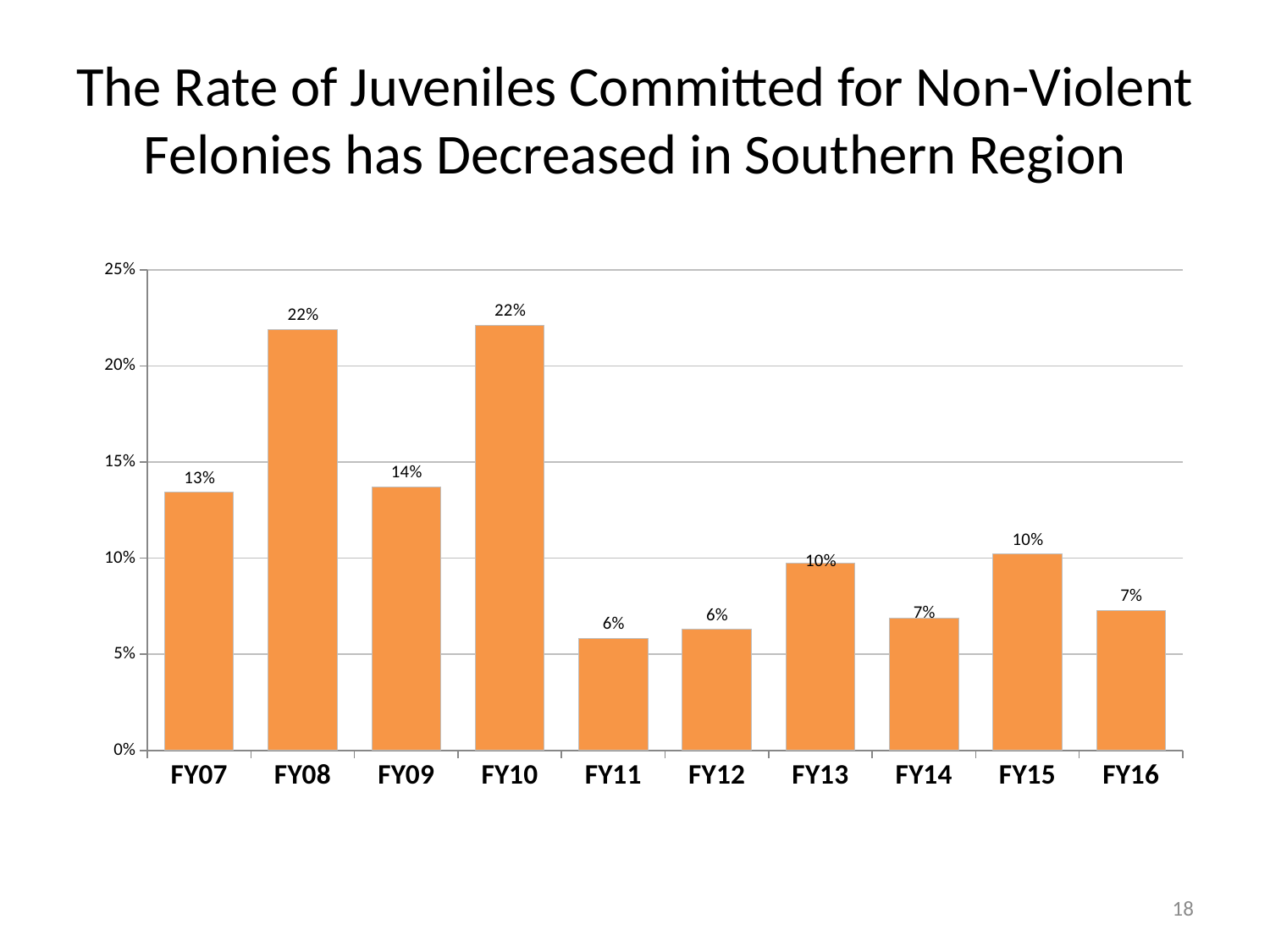
Is the value for FY07 greater or less than 10%? greater Overall, do the values rise or fall from FY07 to FY16? fall What is the value for FY16? 7% Which is larger, the value for FY14 or the value for FY15? FY15 What is the value for FY13? 10% What is the value for FY11? 6% How many fiscal years are shown on the x axis? 10 What is the difference between the values for FY08 and FY07? 9% What is the difference between the values for FY10 and FY16? 15% What is the value for FY07? 13% Which is larger, the value for FY09 or the value for FY11? FY09 What kind of chart is shown on the slide? bar chart